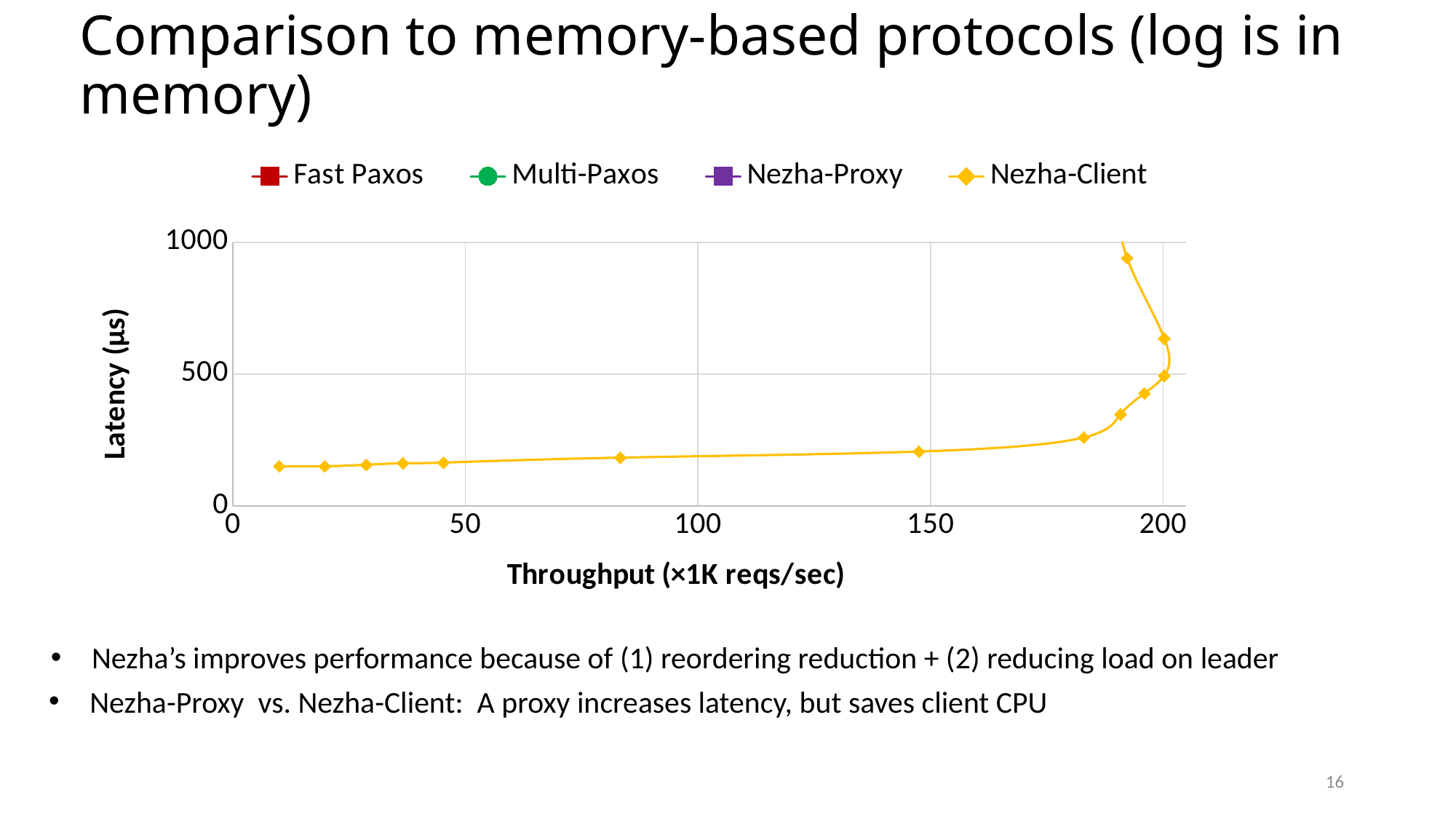
Is the maximum throughput reached by Nezha-Client greater or less than 150 (×1K reqs/sec)? greater Is the highest plotted Nezha-Client latency value greater or less than 500 µs? greater Which series is actually plotted as a visible line on the chart? Nezha-Client Which is larger for Nezha-Client: the latency at a throughput of about 50 or the latency at a throughput of about 195? the latency at about 195 Does the Nezha-Client latency generally rise or fall as throughput increases along the x axis? rise Is the Nezha-Client latency at the lowest throughput point greater or less than 500 µs? less How many series does the legend list? 4 What kind of chart is shown on the slide? line chart What is the label of the y axis? Latency (µs)